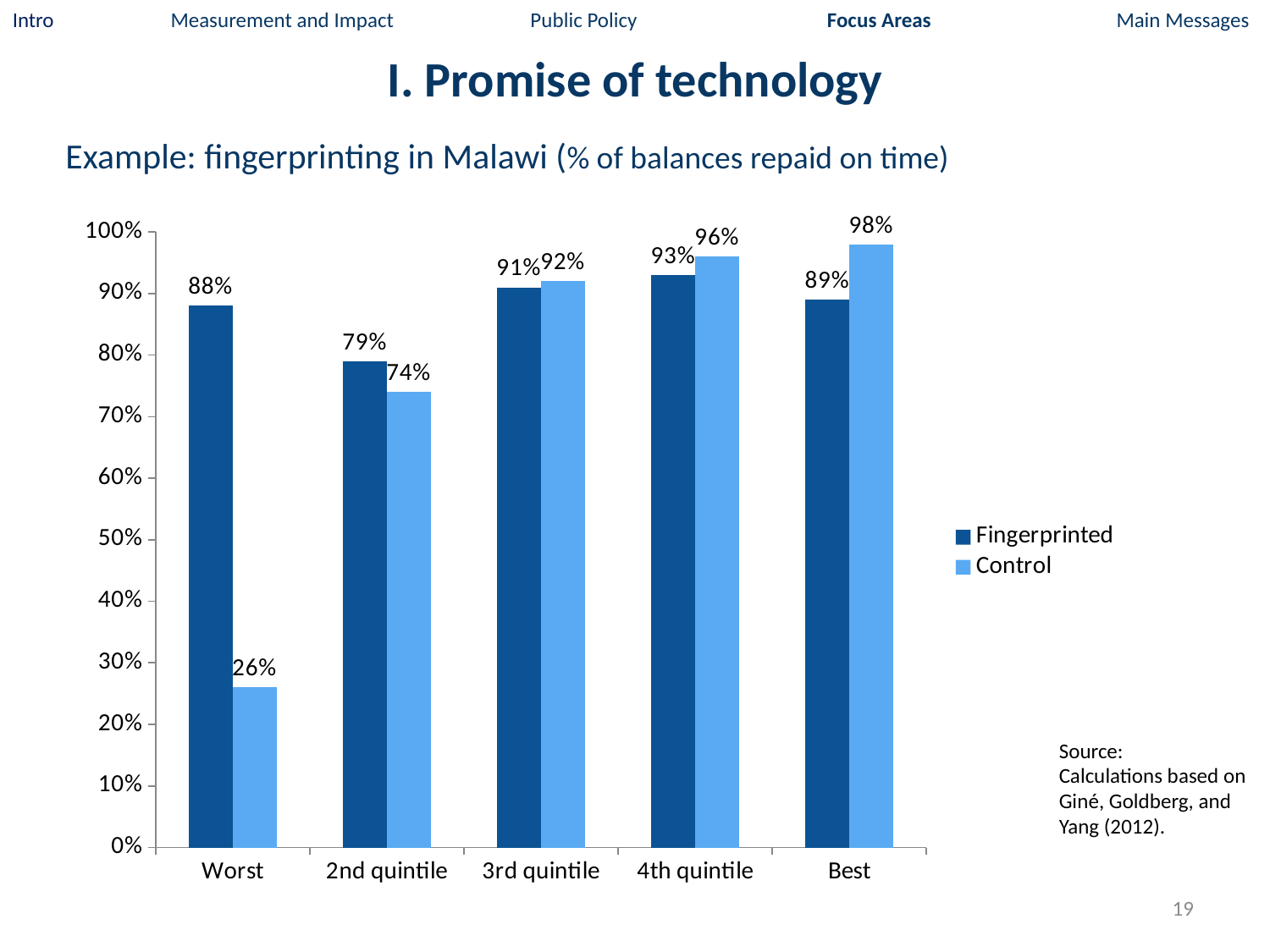
How many series does the legend list? 2 What is the Control value for the 2nd quintile? 74% Which category has the highest Control value? Best How many categories are shown on the x axis? 5 Which category has the highest Fingerprinted value? 4th quintile What is the difference between the Fingerprinted and Control values for the Worst quintile? 62% What is the Fingerprinted value for the Worst quintile? 88% Which category has the lowest Control value? Worst For the Best quintile, which is larger: the Fingerprinted value or the Control value? Control What is the Control value for the Worst quintile? 26% What is the Fingerprinted value for the Best quintile? 89% What kind of chart is shown on the slide? Bar chart